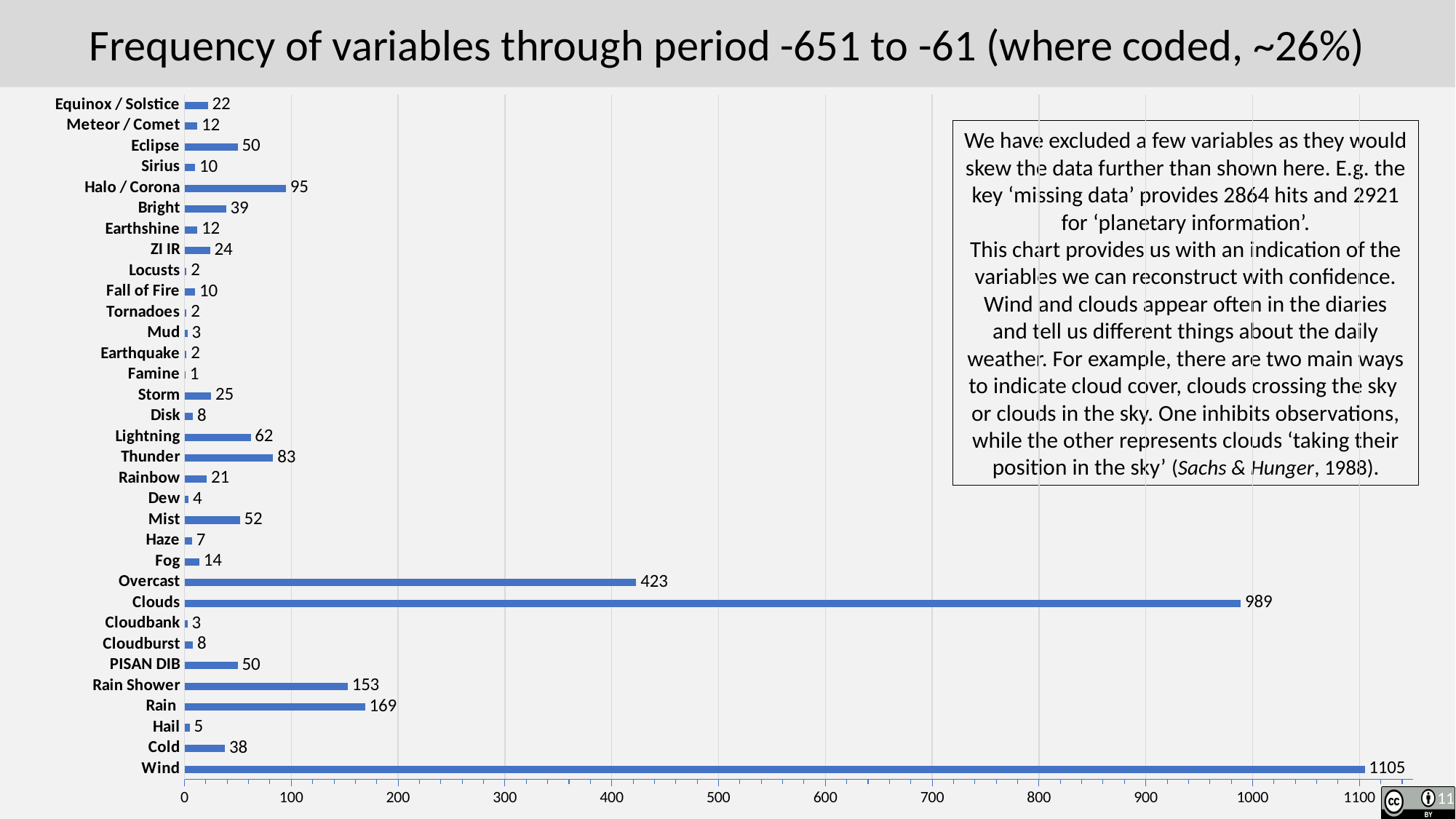
Which category has the highest value? Wind What is the difference between the values for Wind and Clouds? 116 Which is larger, the value for Thunder or the value for Lightning? Thunder What is the value for Rain Shower? 153 Which category has the lowest value? Famine What is the value for Wind? 1105 What is the difference between the values for Rain and Rain Shower? 16 What is the value for Halo / Corona? 95 Is the value for Overcast greater or less than 400? greater What is the value for Clouds? 989 What kind of chart is shown on the slide? bar chart How many categories are shown on the chart? 33